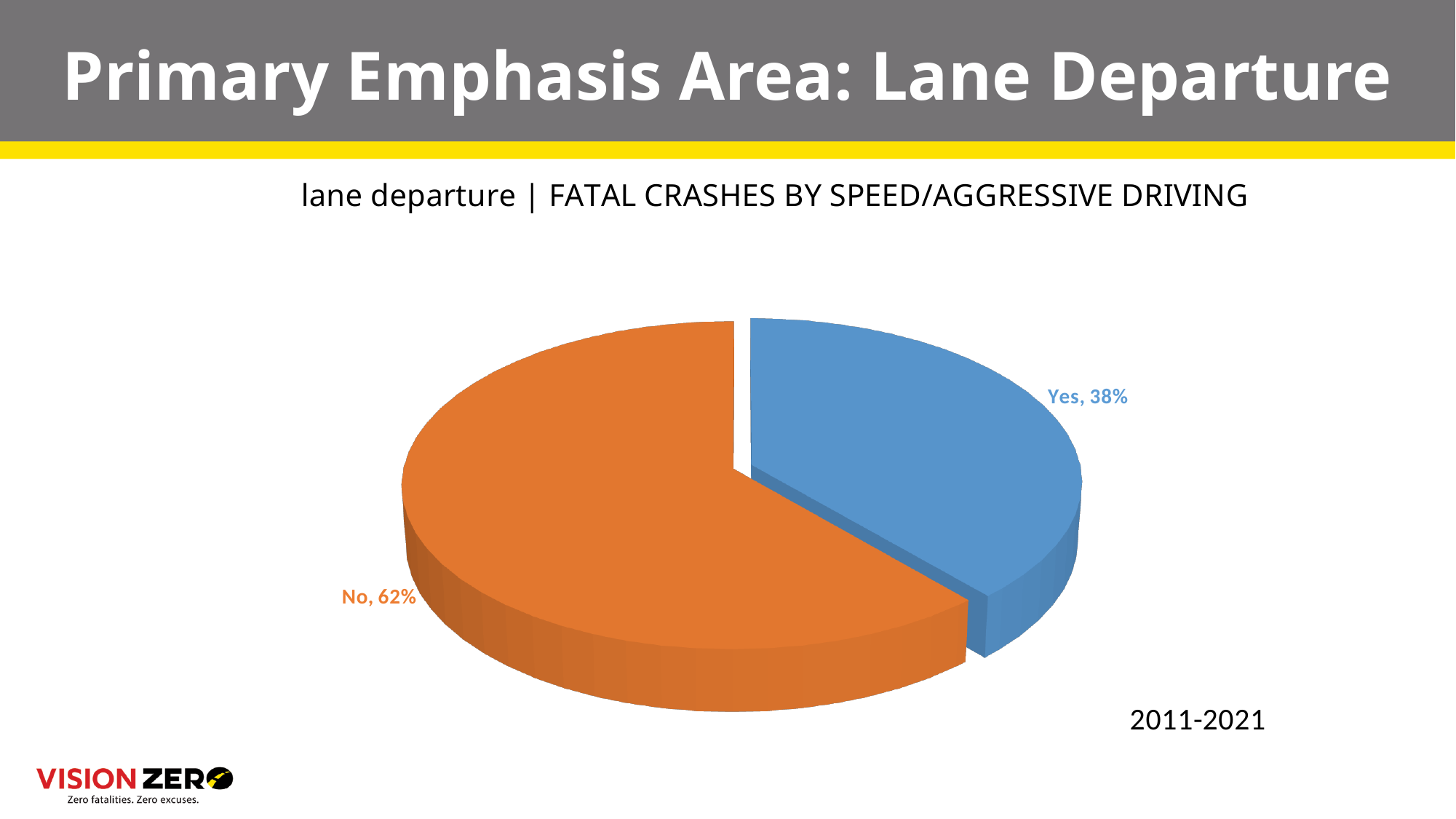
What colour is the Yes slice of the pie chart? Blue What is the title of the chart? lane departure | FATAL CRASHES BY SPEED/AGGRESSIVE DRIVING Which is larger, the Yes slice or the No slice? No Which slice of the pie chart is the smallest? Yes How many slices does the pie chart have? 2 What time period does the chart cover? 2011-2021 What share of lane departure fatal crashes involved speed/aggressive driving (Yes)? 38% What is the difference in percentage points between the No and Yes slices? 24 Which slice of the pie chart is the largest? No What kind of chart is shown on the slide? Pie chart What share of lane departure fatal crashes did not involve speed/aggressive driving (No)? 62%